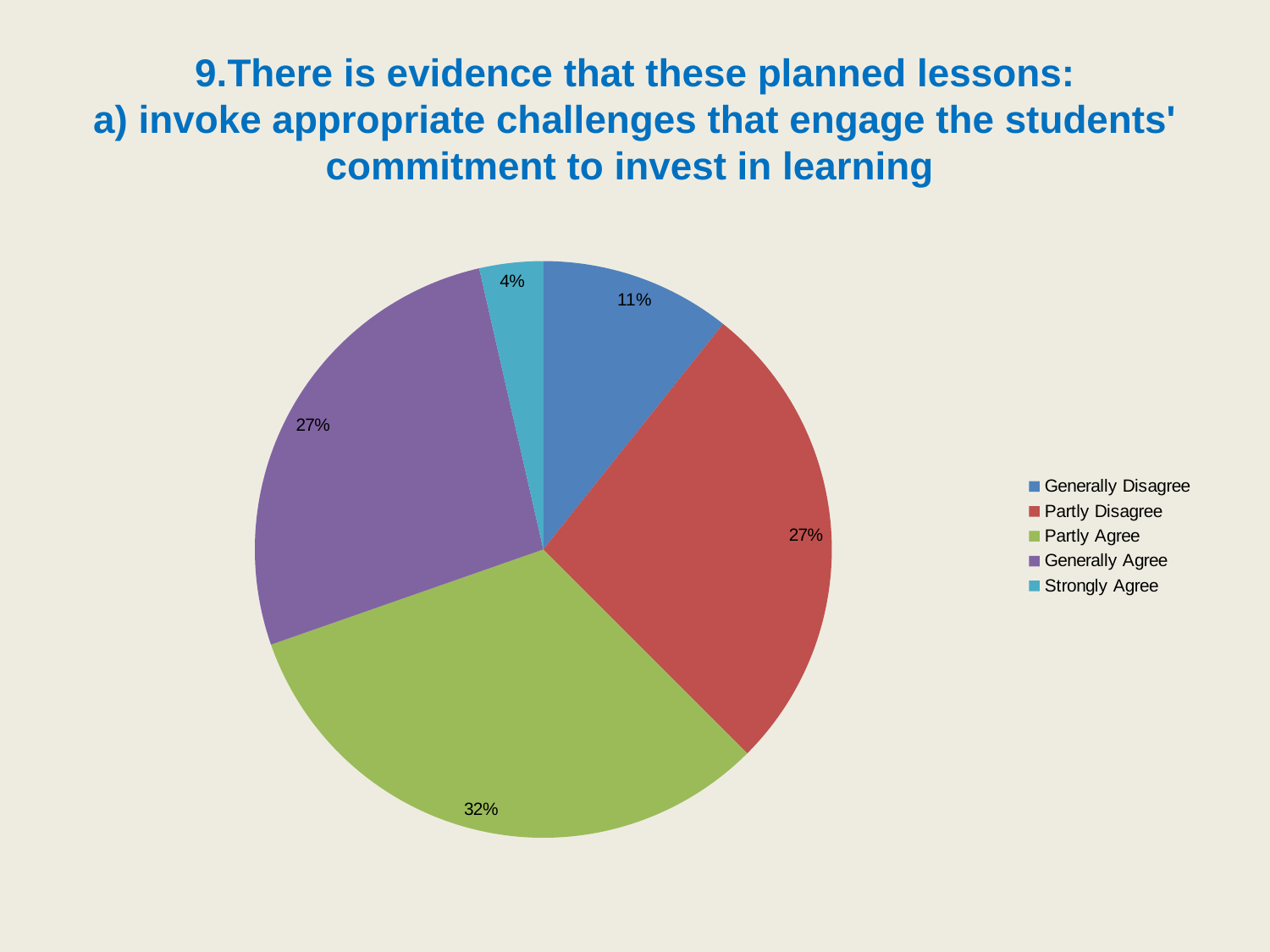
Which is larger, the share for Generally Disagree or the share for Strongly Agree? Generally Disagree Which response category has the largest share of the pie? Partly Agree What colour is the Partly Agree slice? green What percentage of responses are Partly Agree? 32% What is the difference in percentage points between Partly Agree and Generally Disagree? 21 How many categories does the legend list? 5 What is the combined percentage of Generally Agree and Strongly Agree? 31% What kind of chart is shown on the slide? pie chart What percentage of responses are Generally Disagree? 11% Which response category has the smallest share of the pie? Strongly Agree What percentage of responses are Partly Disagree? 27% What percentage of responses are Strongly Agree? 4%